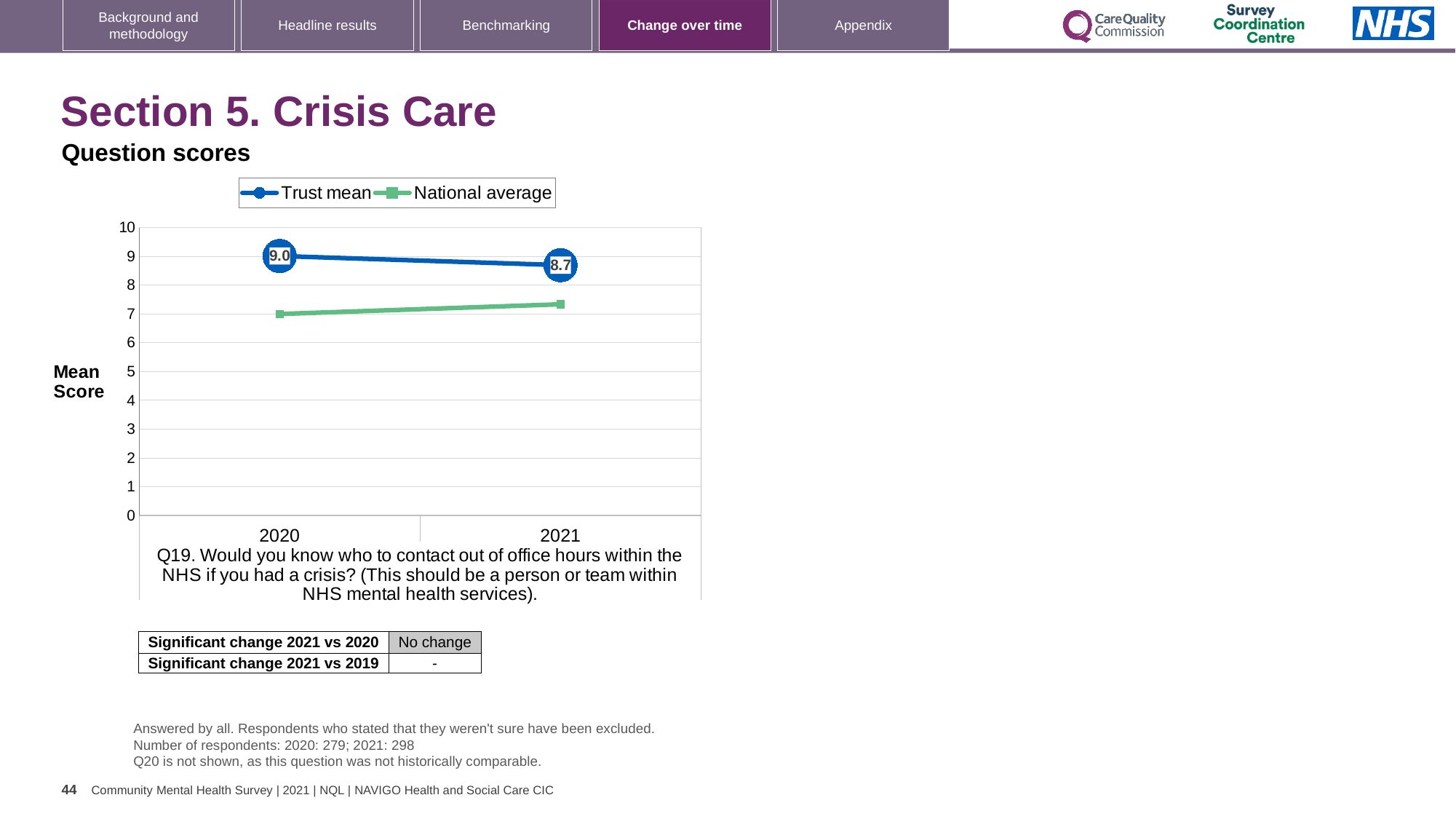
Does the Trust mean rise or fall from 2020 to 2021? Fall How many years are plotted on the x axis? 2 What is the label on the y axis of the chart? Mean Score Which year has the higher Trust mean score, 2020 or 2021? 2020 Is the National average value for 2020 greater or less than 8? less What is the Trust mean score for 2021? 8.7 How many series does the legend list? 2 Is the National average value for 2021 greater or less than 6? greater What is the Trust mean score for 2020? 9.0 What kind of chart is shown on the slide? Line chart By how much did the Trust mean score change from 2020 to 2021? 0.3 In 2021, which series is higher, Trust mean or National average? Trust mean